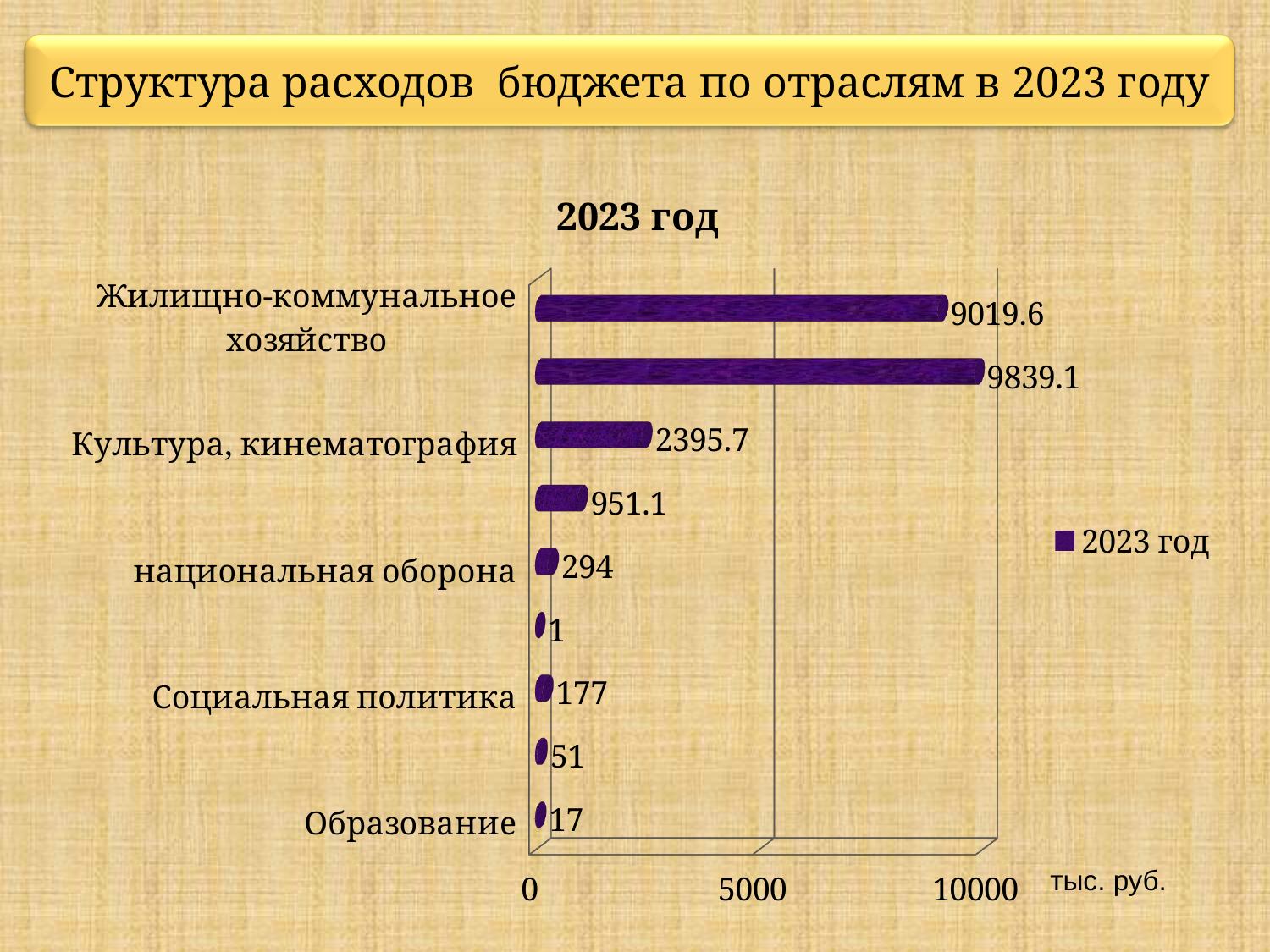
What is the value for национальная оборона? 294 What kind of chart is shown on the slide? bar chart What is the difference between the values for национальная оборона and Социальная политика? 117 What is the value for Культура, кинематография? 2395.7 How many bars are plotted on the chart? 9 What is the value for Социальная политика? 177 What is the value for Жилищно-коммунальное хозяйство? 9019.6 What is the value for Образование? 17 Which is larger, the value for Социальная политика or the value for Образование? Социальная политика What is the difference between the values for Жилищно-коммунальное хозяйство and Культура, кинематография? 6623.9 Is the value for Жилищно-коммунальное хозяйство greater or less than 5000? greater What is the largest value shown on the chart? 9839.1